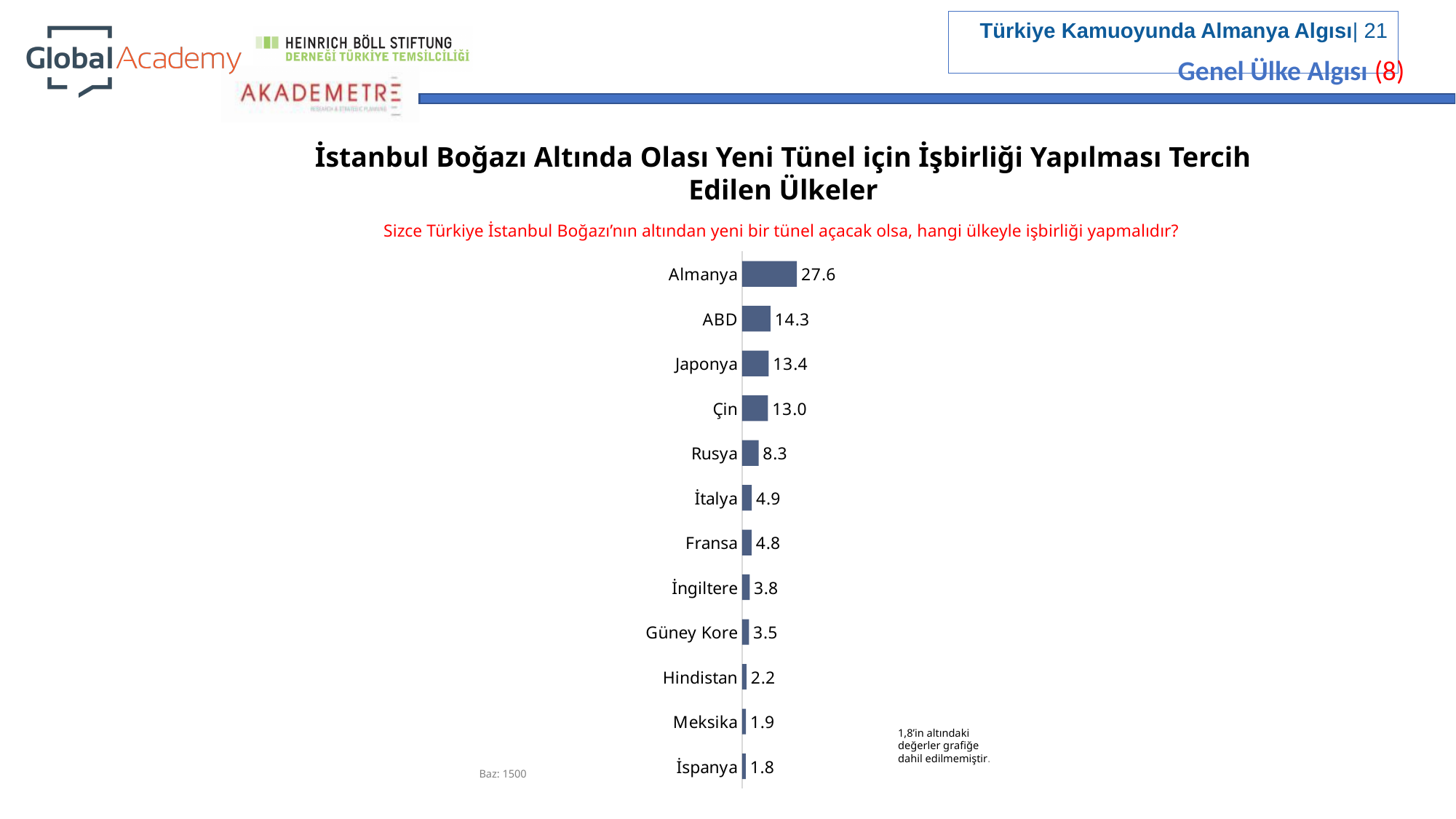
What is the difference between the values for Almanya and ABD? 13.3 Which country has the highest value? Almanya What is the difference between the values for Çin and Rusya? 4.7 What is the value for Almanya? 27.6 Which country has the lowest value shown on the chart? İspanya What is the value for Güney Kore? 3.5 Which has a larger value, Japonya or Çin? Japonya How many countries are shown on the chart? 12 What is the value for Rusya? 8.3 What is the base (Baz) sample size noted on the slide? 1500 Which has a larger value, Hindistan or İngiltere? İngiltere What kind of chart is shown on the slide? Bar chart